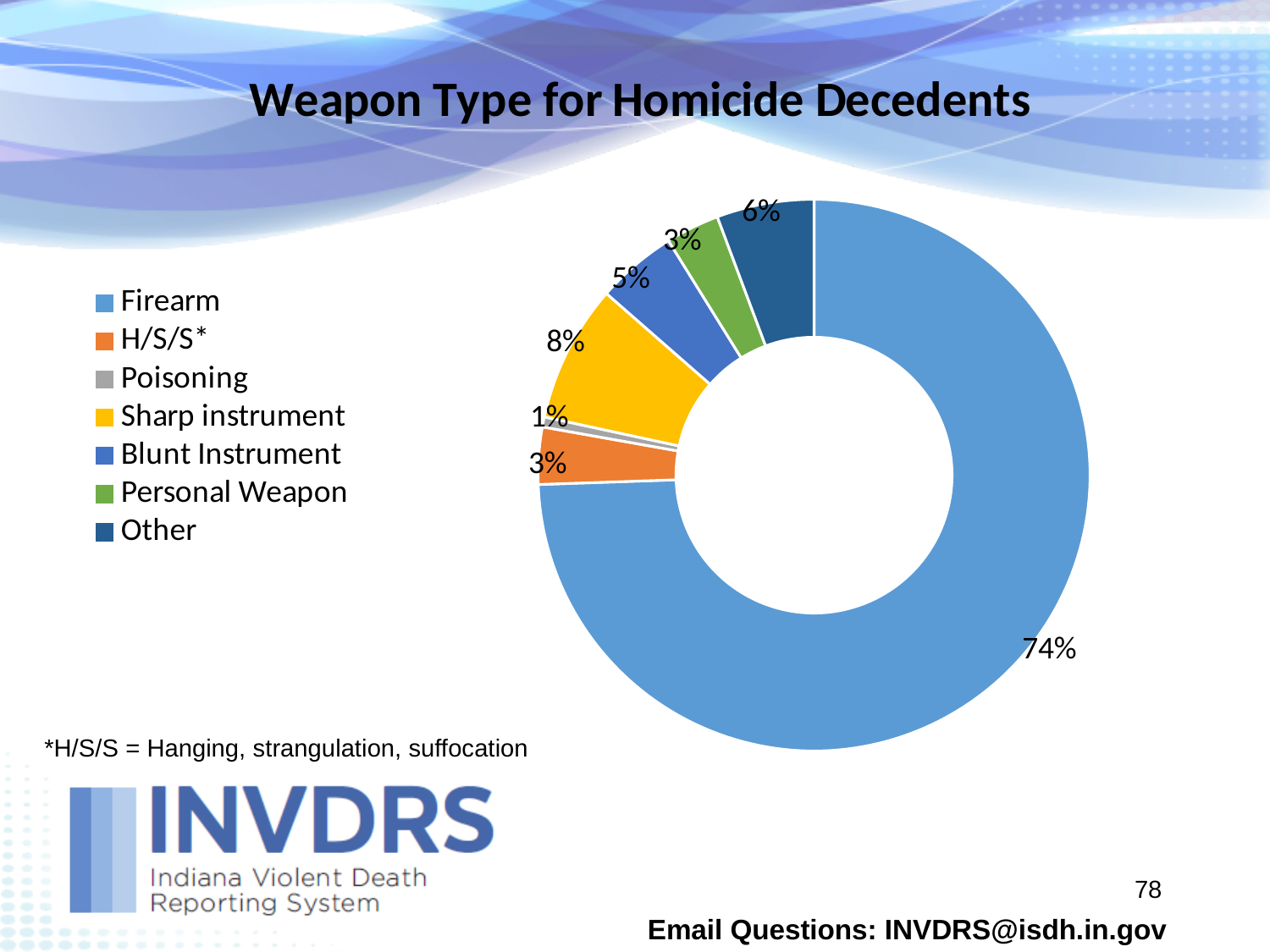
What percentage of homicide decedents had a firearm as the weapon type? 74% Which weapon type has the smallest share of homicide decedents? Poisoning What type of chart is shown on the slide? Pie chart (doughnut) Which weapon type has the largest share of homicide decedents? Firearm According to the footnote, what does H/S/S stand for? Hanging, strangulation, suffocation What percentage is shown for Poisoning? 1% Which is larger, the share for Other or the share for Blunt Instrument? Other What is the difference in percentage points between Firearm and Sharp instrument? 66 What percentage is shown for Sharp instrument? 8% How many weapon type categories does the legend list? 7 What percentage is shown for Other? 6% What percentage is shown for Blunt Instrument? 5%